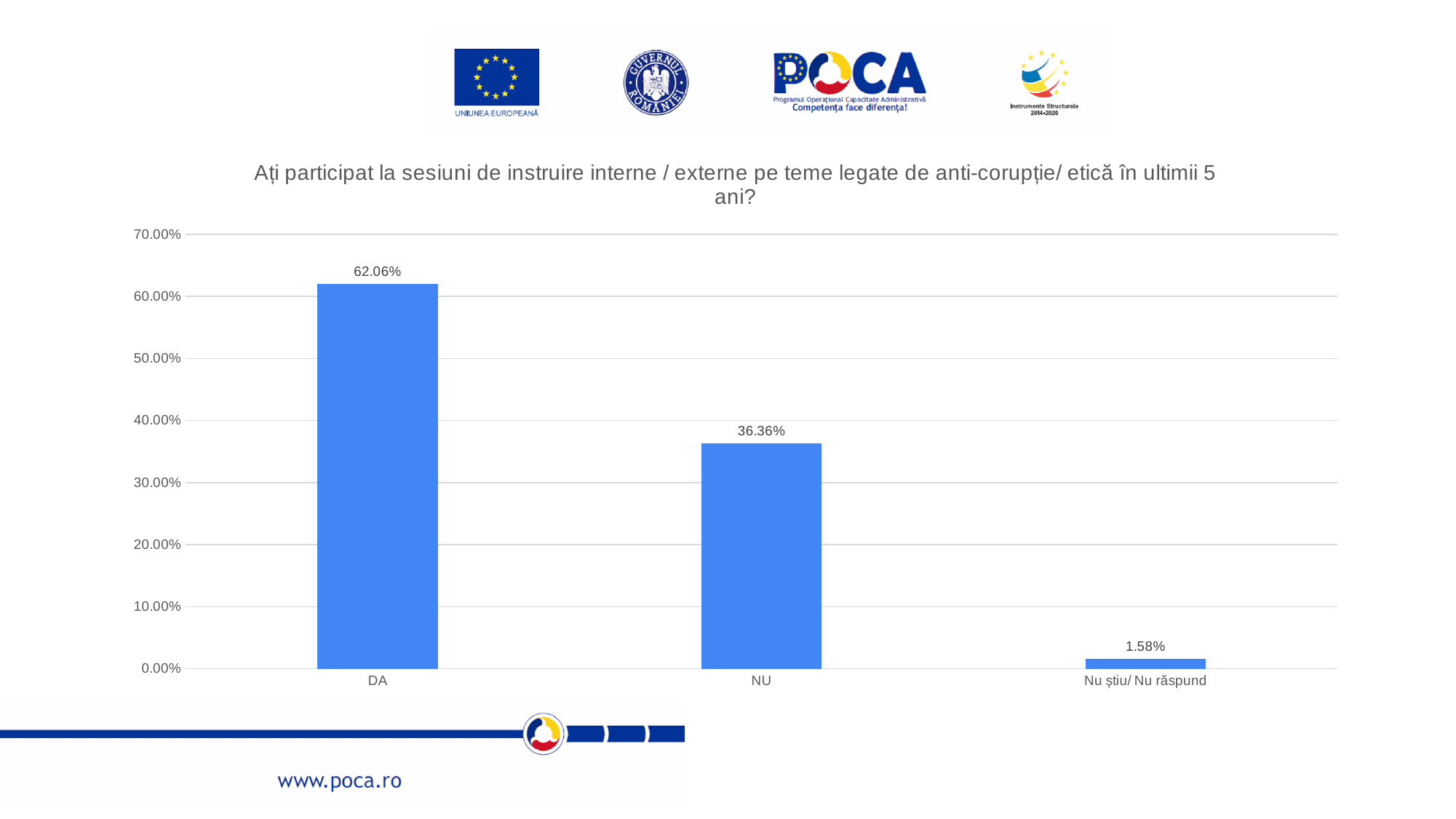
What is the value for DA? 62.06% Is the value for DA greater or less than 60.00%? greater Which category has the lowest value? Nu știu/ Nu răspund Which category has the highest value? DA Do the values rise or fall from left to right along the x axis? fall What is the value for Nu știu/ Nu răspund? 1.58% Is the value for NU greater or less than 40.00%? less What kind of chart is shown on the slide? bar chart How many categories are shown on the x axis? 3 What is the value for NU? 36.36% Which is larger, the value for NU or the value for Nu știu/ Nu răspund? NU What is the difference between the values for DA and NU? 25.70%